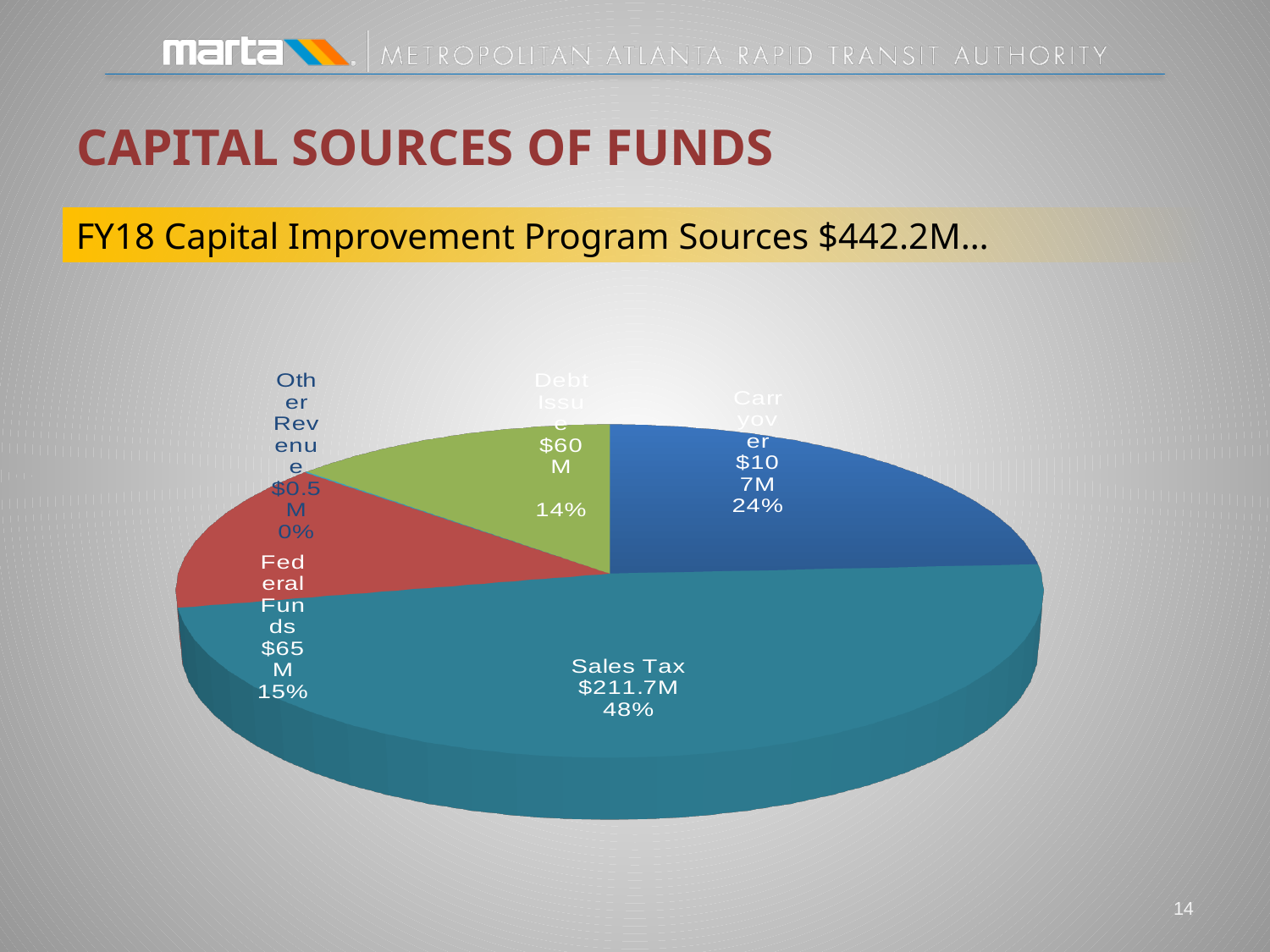
What share of the pie does Carryover represent? 24% What is the difference between the Sales Tax value and the Federal Funds value? $146.7M What kind of chart is shown on the slide? pie chart What share of the pie does Sales Tax represent? 48% What is the value for Debt Issue? $60M How many slices does the pie chart have? 5 What is the value for Sales Tax? $211.7M What percentage of the pie is Federal Funds? 15% Which source has the smallest slice of the pie? Other Revenue Which is larger, Federal Funds or Debt Issue? Federal Funds What is the value for Federal Funds? $65M Which source has the largest slice of the pie? Sales Tax